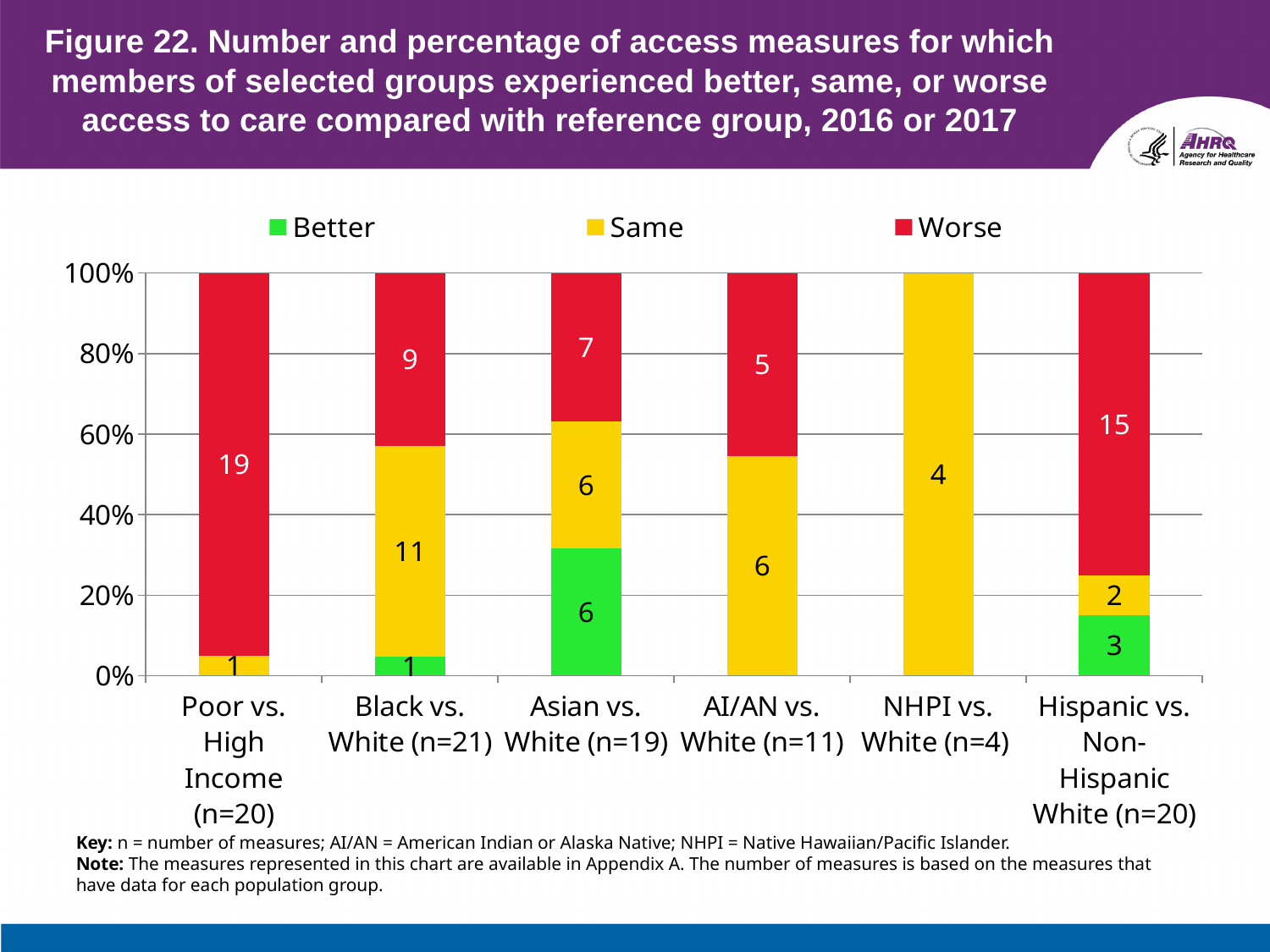
How many series does the legend list? 3 How many access measures were Better for Hispanic vs. Non-Hispanic White? 3 What type of chart is shown on the slide? stacked bar chart Is the Worse share of the bar for Poor vs. High Income greater or less than 80%? greater How many access measures were Worse for Poor vs. High Income? 19 Which group has the largest number of Worse measures? Poor vs. High Income How many comparison groups are shown along the x axis? 6 How many access measures were Same for NHPI vs. White? 4 Which is larger for Asian vs. White: the Worse count or the Same count? Worse What is the difference between the Worse and Better counts for Hispanic vs. Non-Hispanic White? 12 How many access measures were Same for Black vs. White? 11 Which group has the largest number of Better measures? Asian vs. White